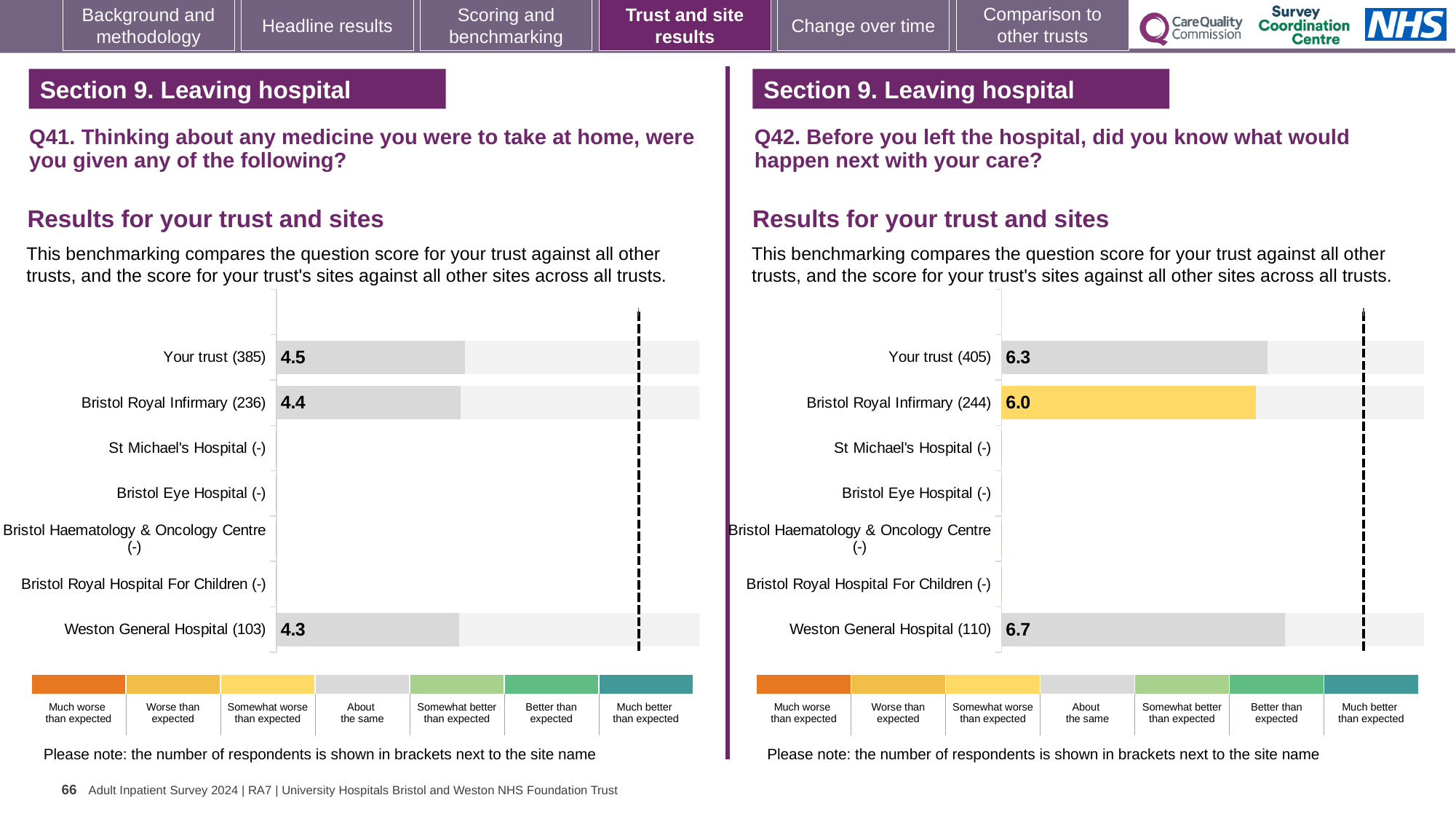
On the Q42 chart (right), what is the difference between the score for Weston General Hospital and the score for Bristol Royal Infirmary? 0.7 On the Q42 chart (right), what is the score for Weston General Hospital? 6.7 On the Q42 chart (right), which site or trust row has the highest score? Weston General Hospital On the Q42 chart (right), what is the score for Bristol Royal Infirmary? 6.0 On the Q41 chart (left), how many rows have a score shown? 3 What kind of chart is used on the Q41 chart (left)? Bar chart On the Q41 chart (left), what is the score for Your trust? 4.5 On the Q42 chart (right), which site or trust row has the lowest score? Bristol Royal Infirmary On the Q41 chart (left), what is the difference between the score for Your trust and the score for Weston General Hospital? 0.2 On the Q41 chart (left), what is the score for Weston General Hospital? 4.3 On the Q42 chart (right), which is larger: the score for Your trust or the score for Bristol Royal Infirmary? Your trust On the Q42 chart (right), which row's bar is coloured yellow (Somewhat worse than expected)? Bristol Royal Infirmary